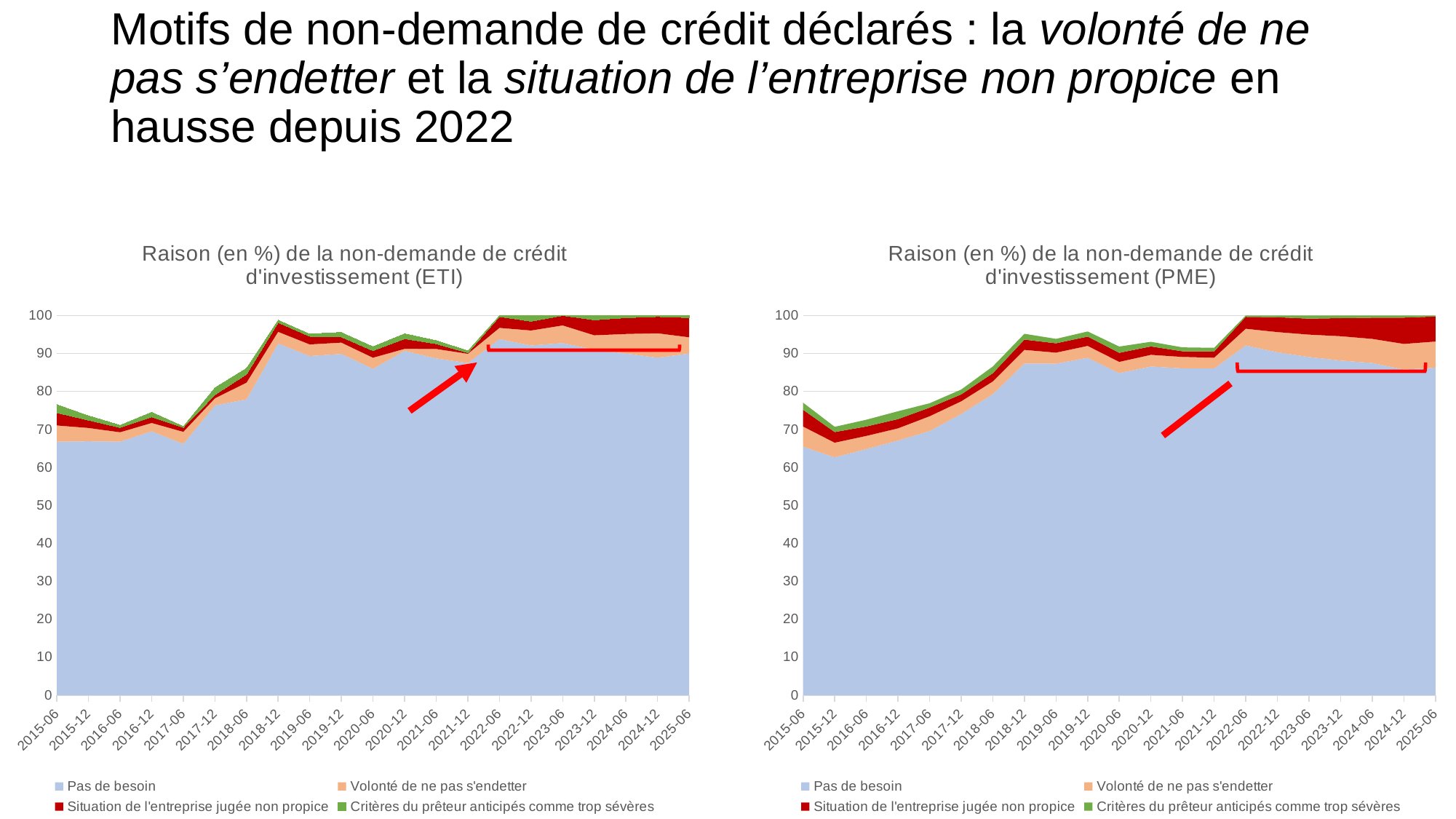
In the left chart (ETI), is the value for 'Pas de besoin' at 2015-06 greater or less than 70? less How many series does the legend of the right chart (PME) list? 4 Which legend entry is shown in dark red on both charts? Situation de l'entreprise jugée non propice In the left chart (ETI), is 'Pas de besoin' larger at 2018-12 or at 2015-06? 2018-12 What kind of chart is the left chart, 'Raison (en %) de la non-demande de crédit d'investissement (ETI)'? Stacked area chart In the left chart (ETI), which series occupies the largest share of the stacked area? Pas de besoin In the right chart (PME), is the value for 'Pas de besoin' at 2015-12 greater or less than 70? less How many dates are labelled on the x axis of the left chart (ETI)? 21 In the right chart (PME), is the value for 'Pas de besoin' at 2025-06 greater or less than 90? less In the right chart (PME), does the 'Pas de besoin' area rise or fall between 2015-12 and 2018-12? Rise In the right chart (PME), does the 'Pas de besoin' area rise or fall between 2022-06 and 2025-06? Fall